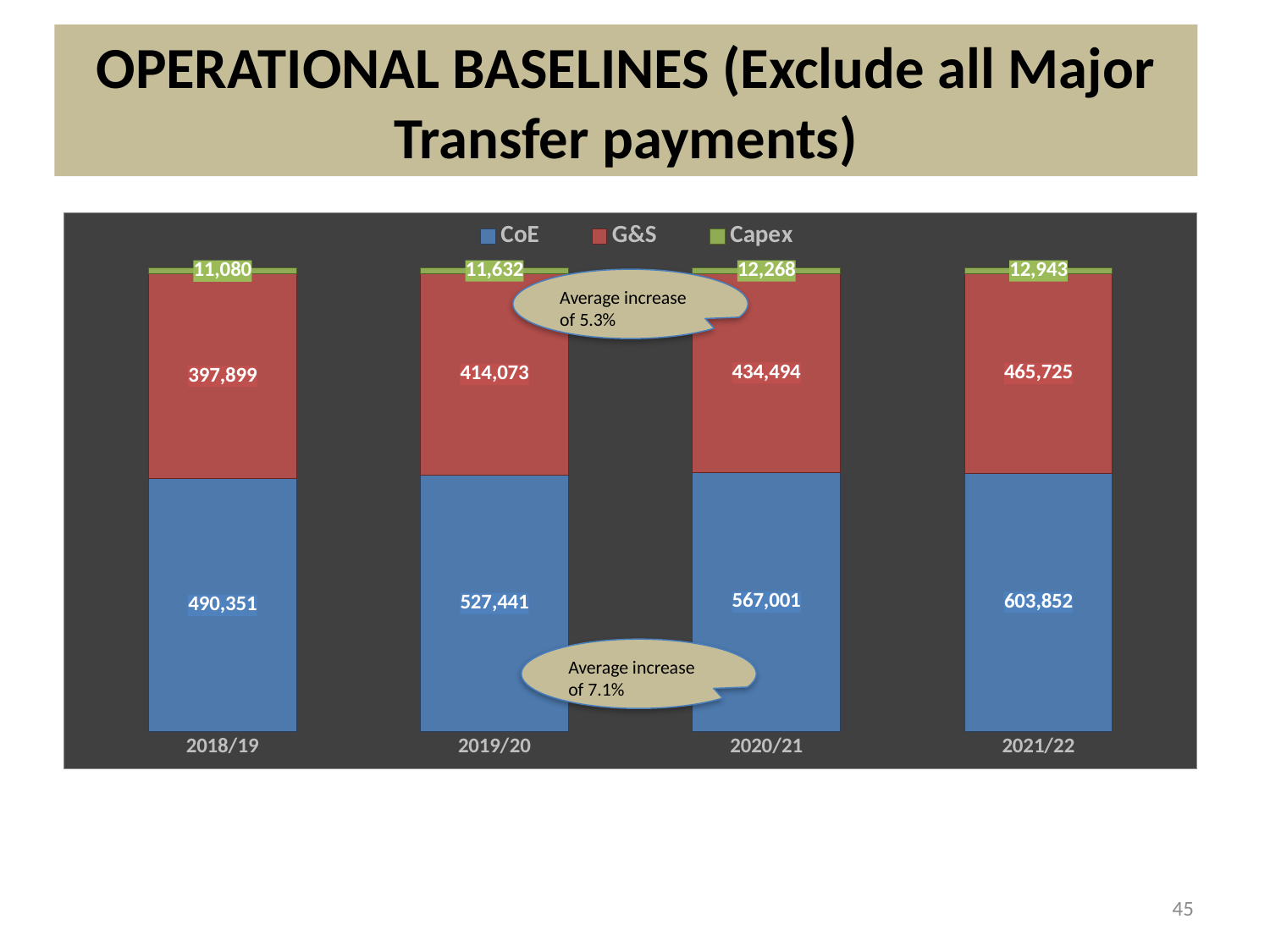
Which year has the lowest Capex value? 2018/19 What kind of chart is shown on the slide? Stacked bar chart Which is larger, the G&S value for 2019/20 or the G&S value for 2020/21? 2020/21 Do the CoE values rise or fall from 2018/19 to 2021/22? Rise Which year has the highest CoE value? 2021/22 What is the G&S value for 2021/22? 465,725 What is the CoE value for 2019/20? 527,441 What is the Capex value for 2020/21? 12,268 How many financial years are shown on the x axis? 4 What is the total of the stacked bar for 2018/19? 899,330 How many series does the legend list? 3 What is the difference between the CoE value for 2021/22 and the CoE value for 2018/19? 113,501